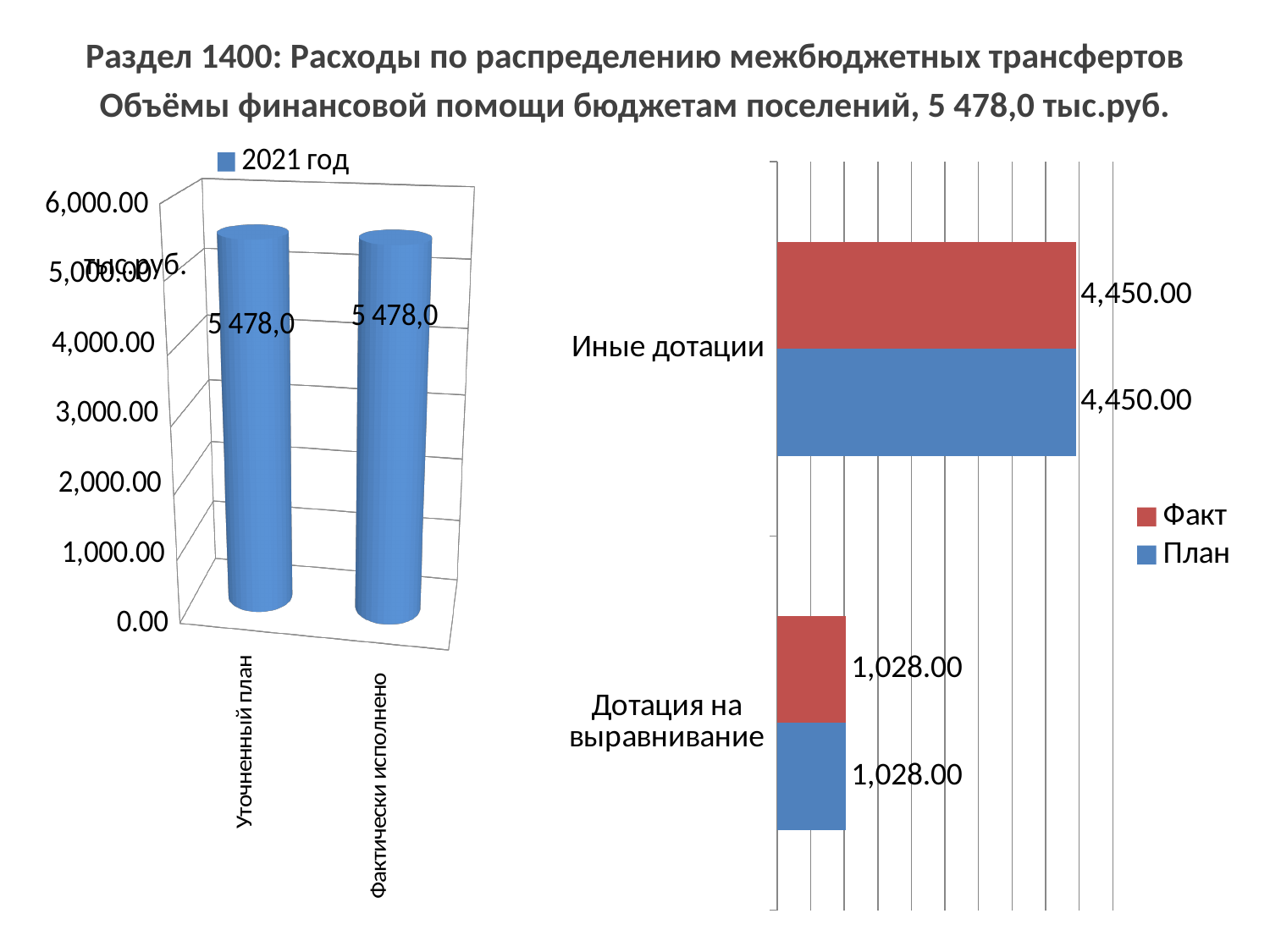
In the right chart, which category has the highest Факт value? Иные дотации In the right chart, which category has the lowest План value? Дотация на выравнивание In the left chart, what is the value for Уточненный план? 5 478,0 In the left chart, what series does the legend list? 2021 год What kind of chart is the right chart? Bar chart In the right chart, how many series does the legend list? 2 In the right chart, what is the Факт value for Дотация на выравнивание? 1,028.00 In the right chart, what is the План value for Иные дотации? 4,450.00 In the right chart, what is the difference between the Факт value for Иные дотации and the Факт value for Дотация на выравнивание? 3,422.00 In the left chart, is the value for Уточненный план greater or less than 5,000.00? greater In the left chart, what is the value for Фактически исполнено? 5 478,0 In the left chart, how many categories are shown on the x axis? 2